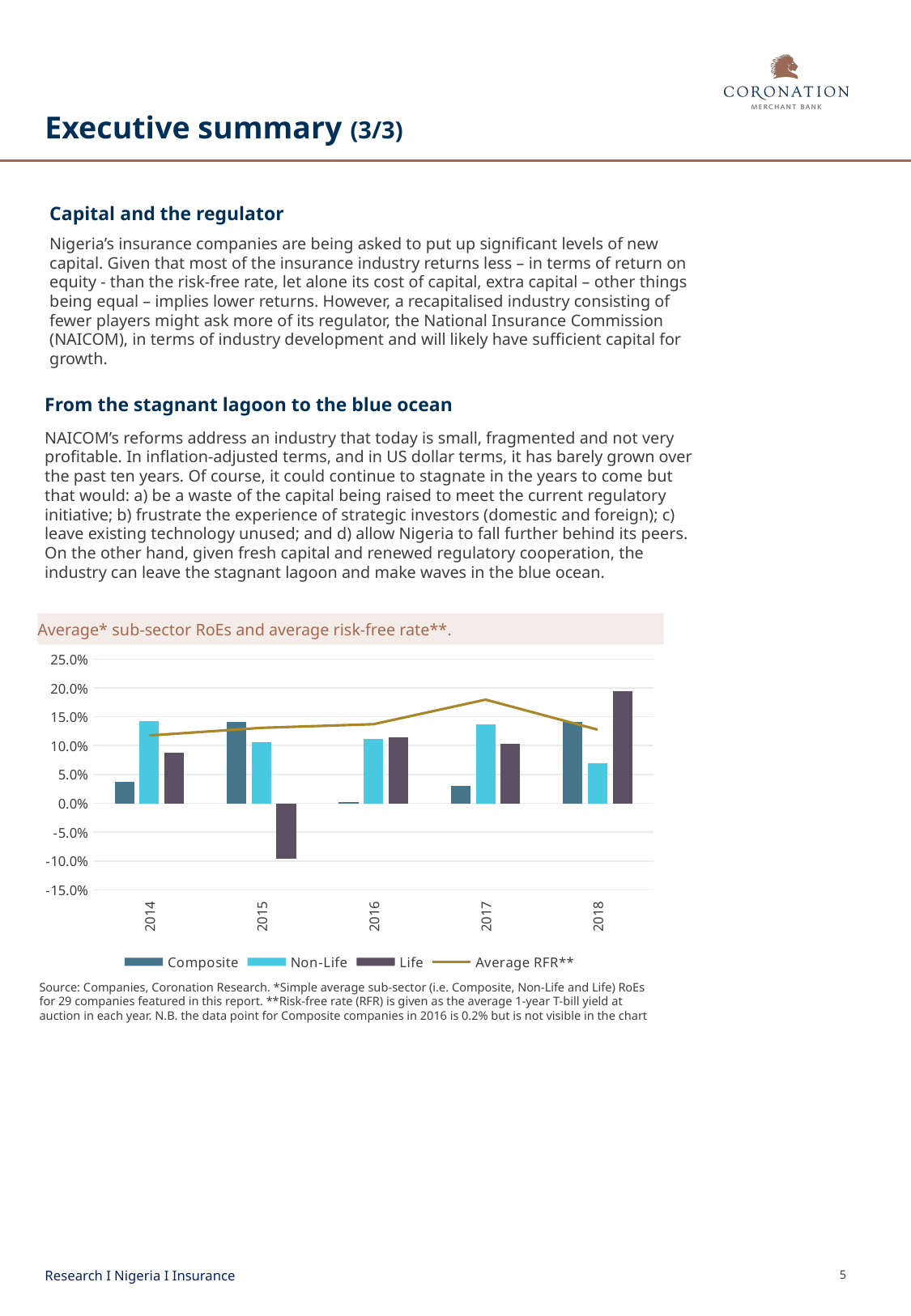
In 2018, which is larger: the Non-Life RoE or the Life RoE? Life Is the Life value for 2018 greater or less than 15.0%? greater What is the Composite RoE value for 2016, as stated in the note below the chart? 0.2% What kind of chart is shown on the slide? bar chart with a line Is the Composite value for 2014 greater or less than 5.0%? less How many series does the chart legend list? 4 What is the title of the chart? Average* sub-sector RoEs and average risk-free rate**. In which year does the Average RFR line reach its highest point? 2017 In which year is the Life RoE negative? 2015 Is the Life value for 2015 greater or less than -5.0%? less How many years are shown on the x axis of the chart? 5 In which year is the Life RoE highest? 2018